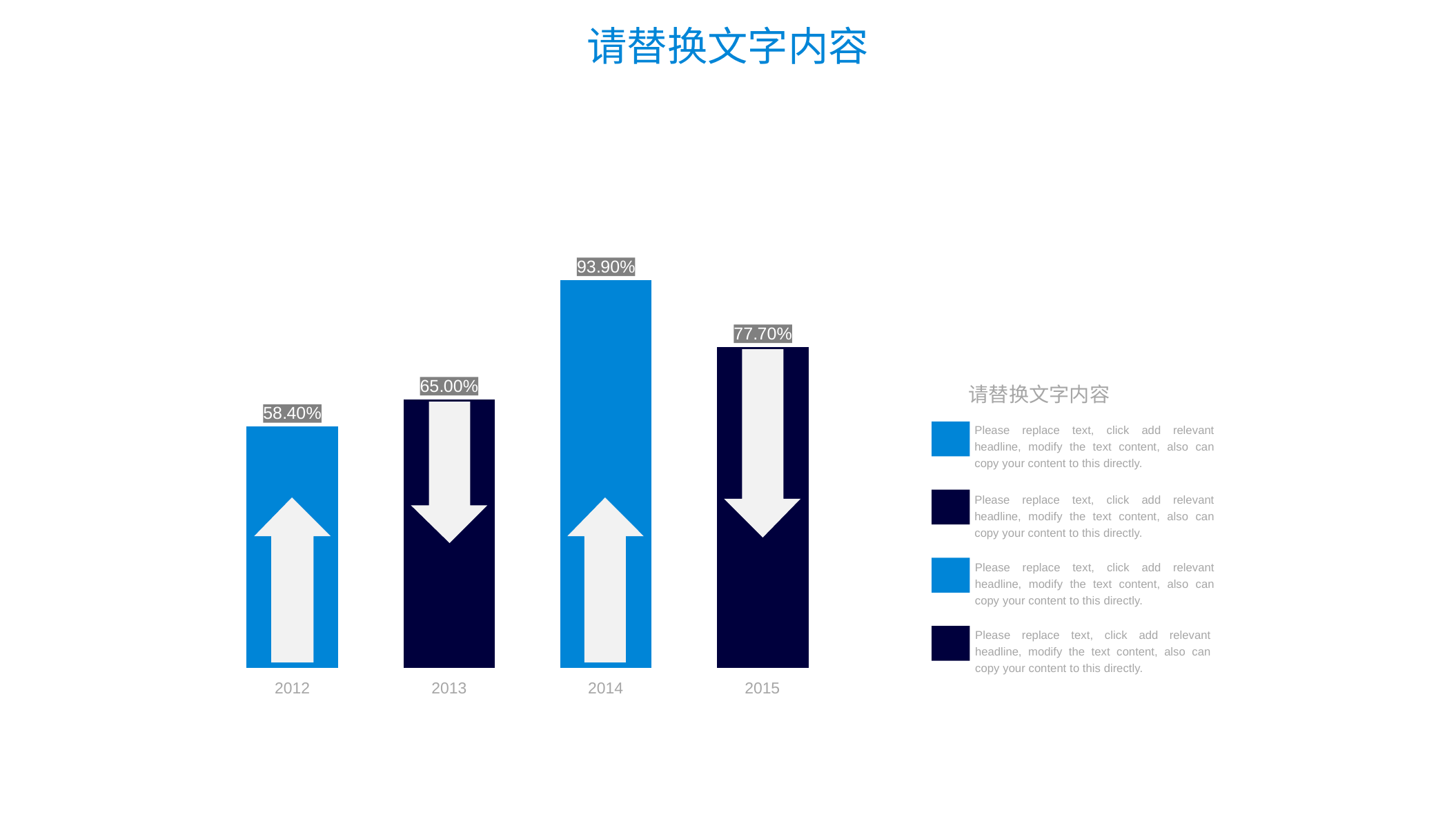
Which year has the highest value? 2014 What is the value for 2015? 77.70% What is the value for 2012? 58.40% What is the value for 2014? 93.90% How many years are shown on the x axis? 4 What kind of chart is shown on the slide? bar chart Which year has the lowest value? 2012 What colour is the bar for 2014? light blue What is the difference between the values for 2013 and 2012? 6.60% Which is larger, the value for 2013 or the value for 2015? 2015 What is the difference between the values for 2014 and 2015? 16.20% What is the value for 2013? 65.00%